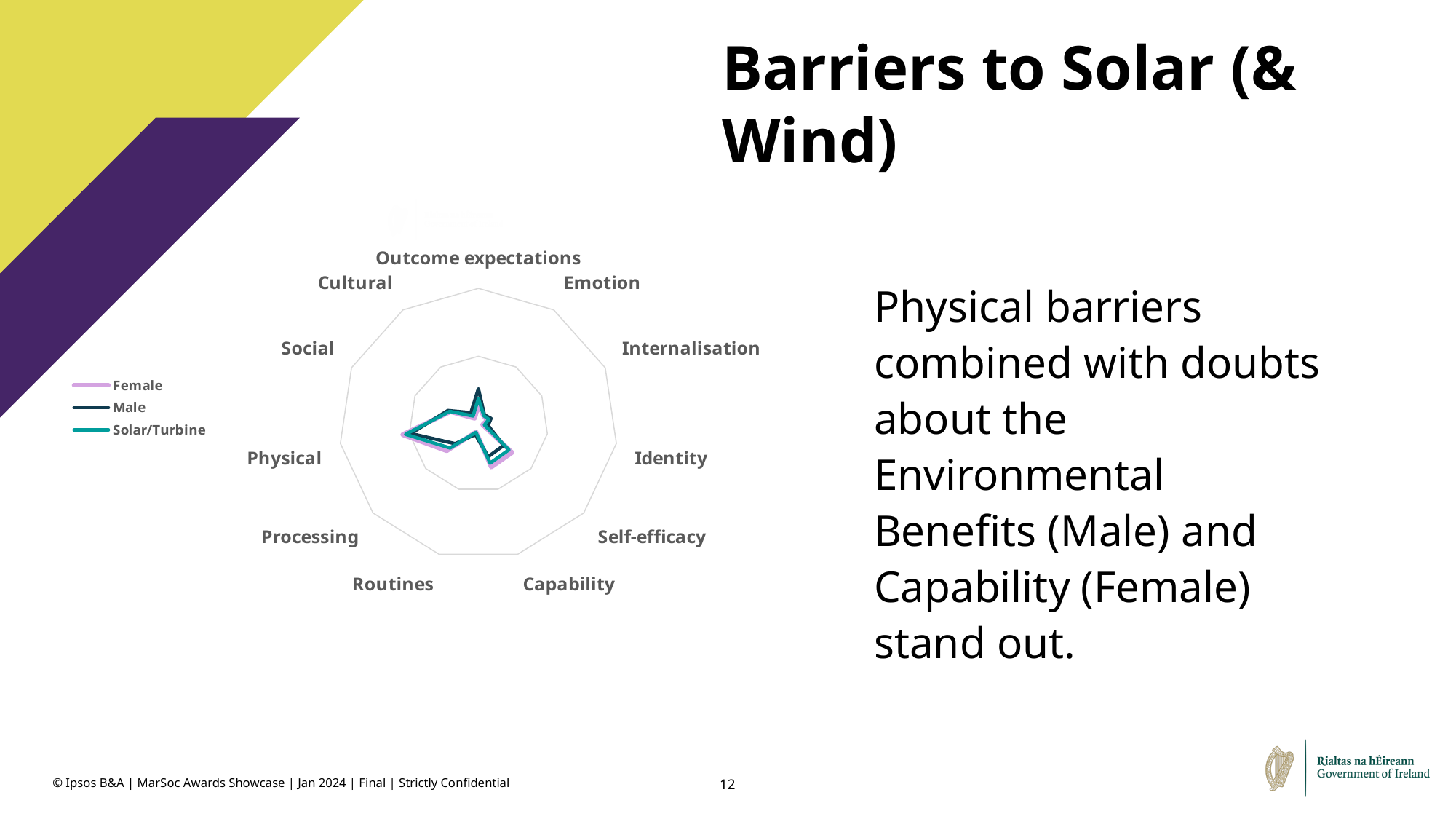
Which category label appears at the top of the radar chart? Outcome expectations Which category has the highest values on the radar chart? Physical How many categories (axes) does the radar chart have? 11 How many series does the legend of the radar chart list? 3 What are the three series listed in the legend of the radar chart? Female, Male, Solar/Turbine Which series in the radar chart legend is shown in purple? Female Which is larger on the radar chart: the value for Physical or the value for Emotion? Physical Which is larger on the radar chart: the value for Physical or the value for Identity? Physical What kind of chart is shown on the slide? Radar chart